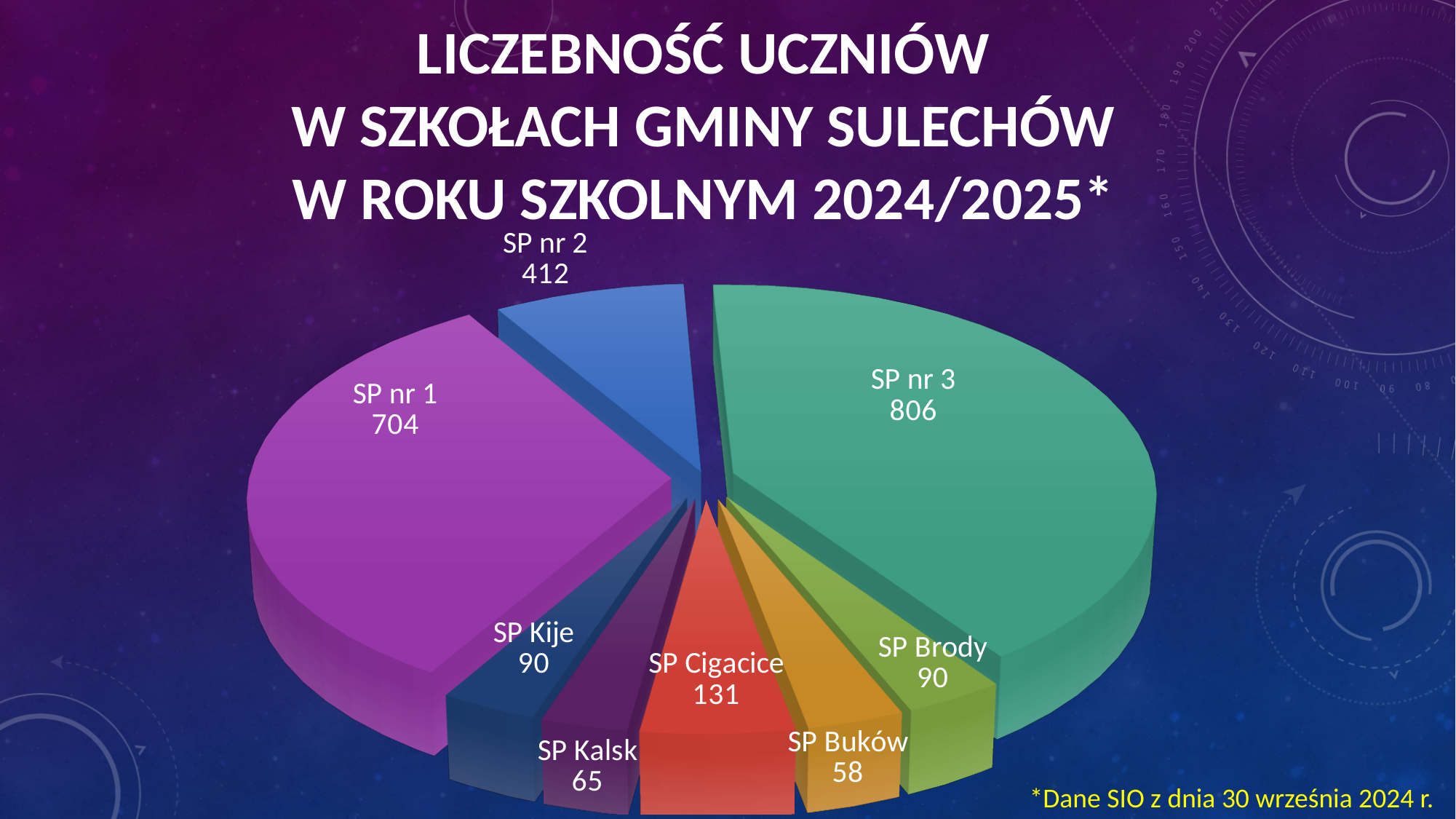
Which two schools have the same value of 90 in the chart? SP Kije and SP Brody What kind of chart is shown on the slide? Pie chart How many students does SP nr 3 have according to the chart? 806 What is the value shown for SP Cigacice? 131 What is the difference between the values for SP nr 3 and SP nr 1? 102 Which school has the smallest number of students in the chart? SP Buków Which has more students, SP nr 2 or SP nr 1? SP nr 1 What is the difference between the values for SP nr 2 and SP Cigacice? 281 How many schools (slices) are shown in the chart? 8 Which school has the largest number of students in the chart? SP nr 3 What is the total number of students across all slices of the chart? 2356 What is the value shown for SP Kalsk? 65